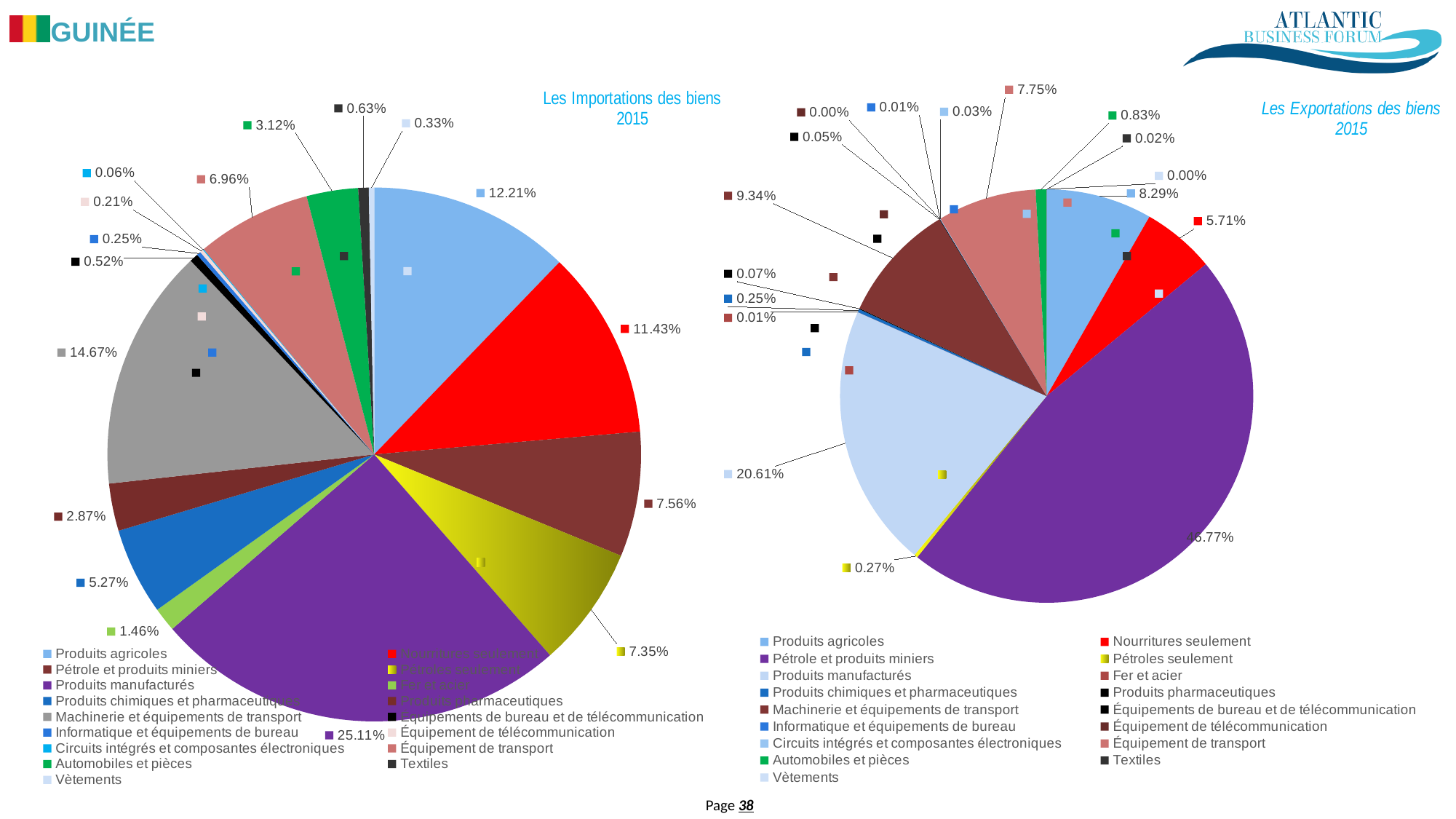
What type of chart is 'Les Importations des biens 2015'? Pie chart In the 'Les Exportations des biens 2015' pie chart, what share is shown for Produits manufacturés? 20.61% In the 'Les Exportations des biens 2015' pie chart, what share is shown for Machinerie et équipements de transport? 9.34% How many categories does the legend of the 'Les Exportations des biens 2015' chart list? 17 In the 'Les Exportations des biens 2015' pie chart, which is larger: Produits agricoles or Équipement de transport? Produits agricoles In the 'Les Exportations des biens 2015' pie chart, which category has the largest share? Pétrole et produits miniers In the 'Les Exportations des biens 2015' pie chart, what is the difference between the shares of Produits agricoles and Nourritures seulement? 2.58% In the 'Les Importations des biens 2015' pie chart, what share is shown for Produits manufacturés? 25.11% In the 'Les Importations des biens 2015' pie chart, which is larger: Équipement de transport or Produits chimiques et pharmaceutiques? Équipement de transport In the 'Les Importations des biens 2015' pie chart, which category has the largest share? Produits manufacturés In the 'Les Importations des biens 2015' pie chart, what share is shown for Machinerie et équipements de transport? 14.67% In the 'Les Importations des biens 2015' pie chart, what is the difference between the shares of Produits agricoles and Nourritures seulement? 0.78%